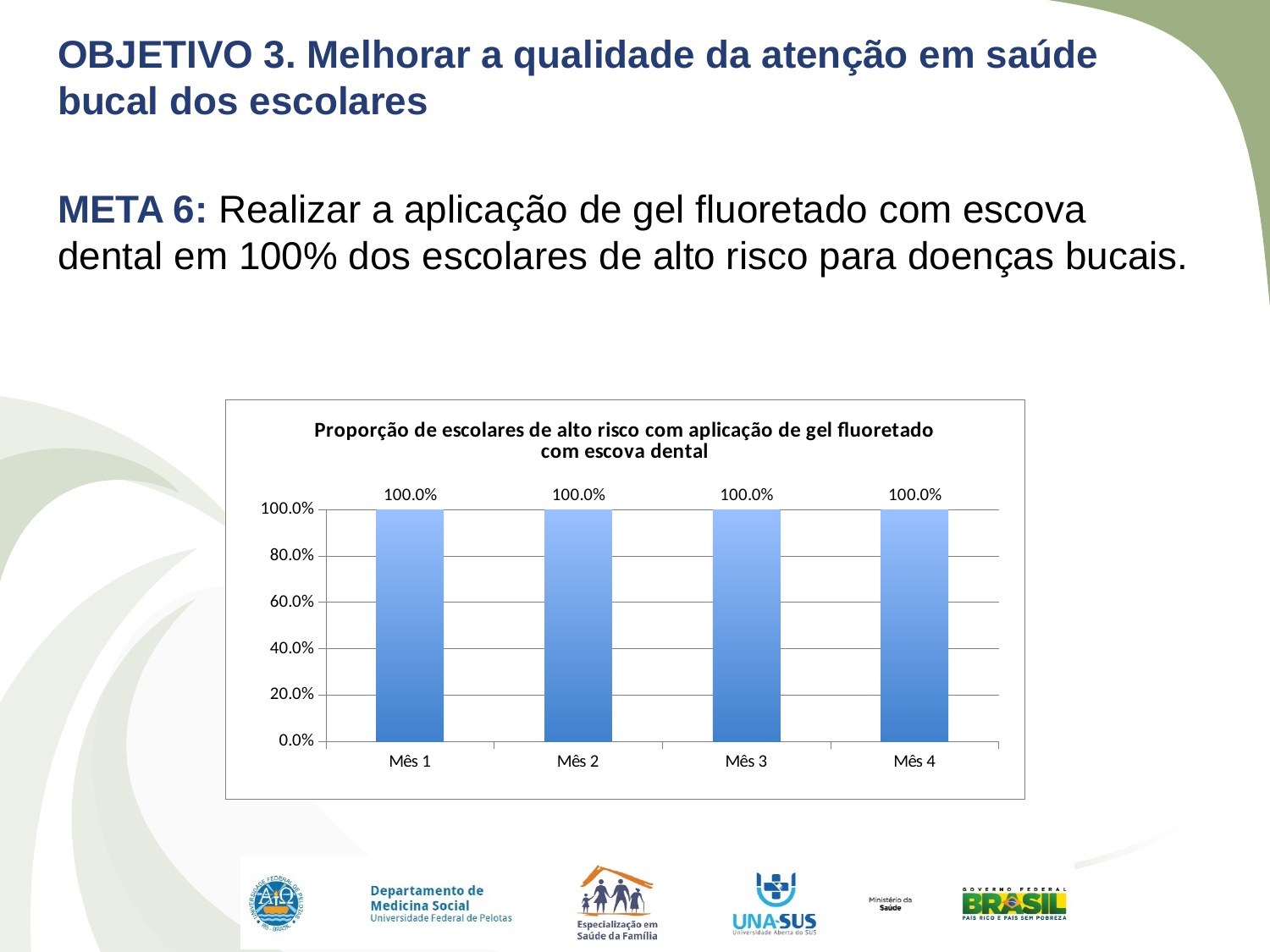
Is the value for Mês 2 greater or less than 80.0%? greater What is the value for Mês 1? 100.0% How many categories are shown on the x axis? 4 What is the difference between the values for Mês 2 and Mês 4? 0.0% Do the values rise, fall or stay the same from Mês 1 to Mês 4? Stay the same What is the value for Mês 3? 100.0% What is the highest value shown on the y axis? 100.0% What is the value for Mês 4? 100.0% What is the title of the chart? Proporção de escolares de alto risco com aplicação de gel fluoretado com escova dental What kind of chart is shown on the slide? Bar chart